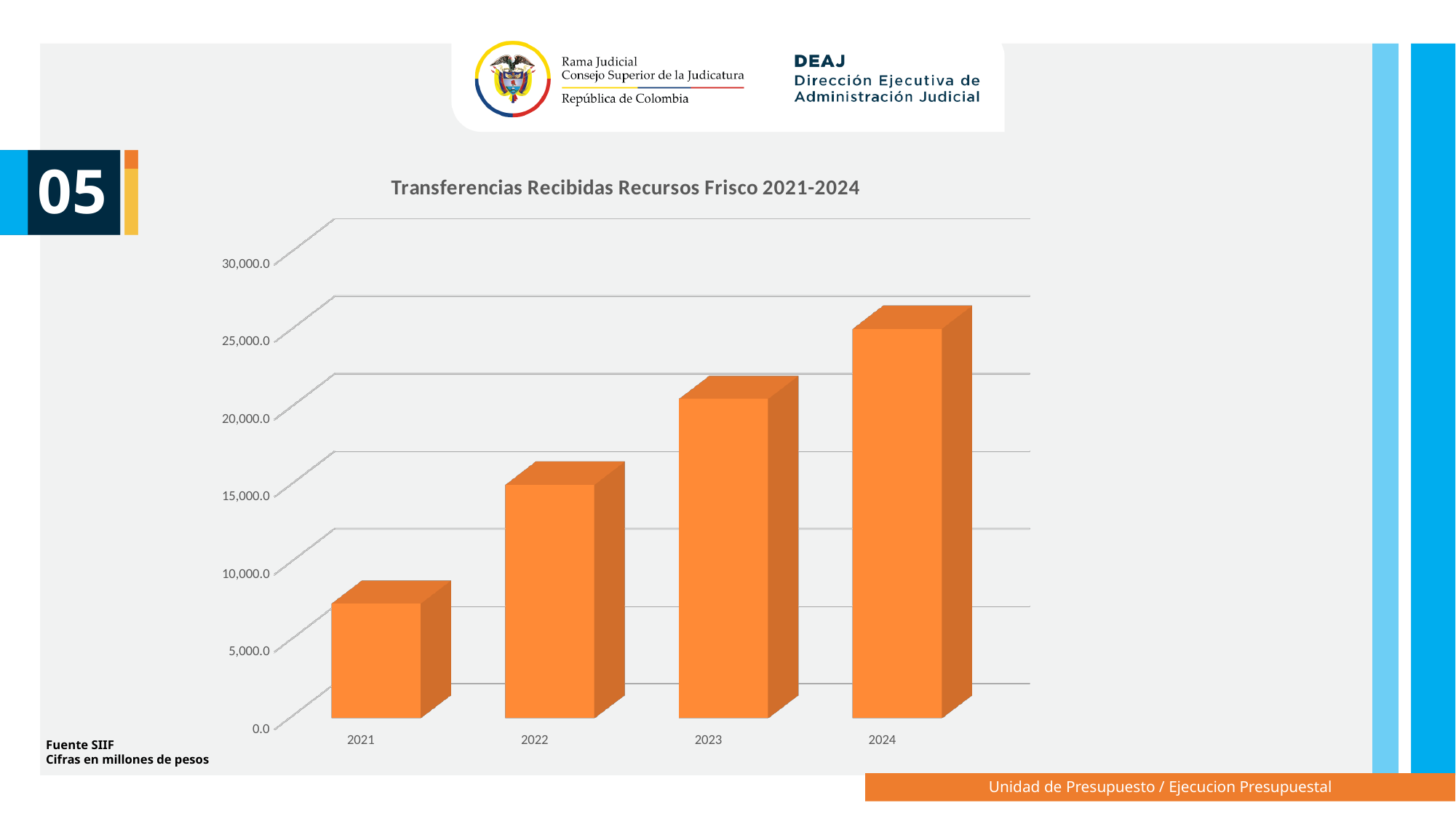
What kind of chart is shown on the slide? bar chart Which year has the highest value for Transferencias Recibidas Recursos Frisco? 2024 What is the title of the chart? Transferencias Recibidas Recursos Frisco 2021-2024 Is the value for 2021 greater or less than 5,000.0? greater Is the value for 2024 greater or less than 30,000.0? less Is the value for 2022 greater or less than 20,000.0? less How many years (categories) are plotted on the x axis? 4 Which year has the lowest value for Transferencias Recibidas Recursos Frisco? 2021 Do the values rise or fall from 2021 to 2024? rise Which is larger, the value for 2022 or the value for 2023? 2023